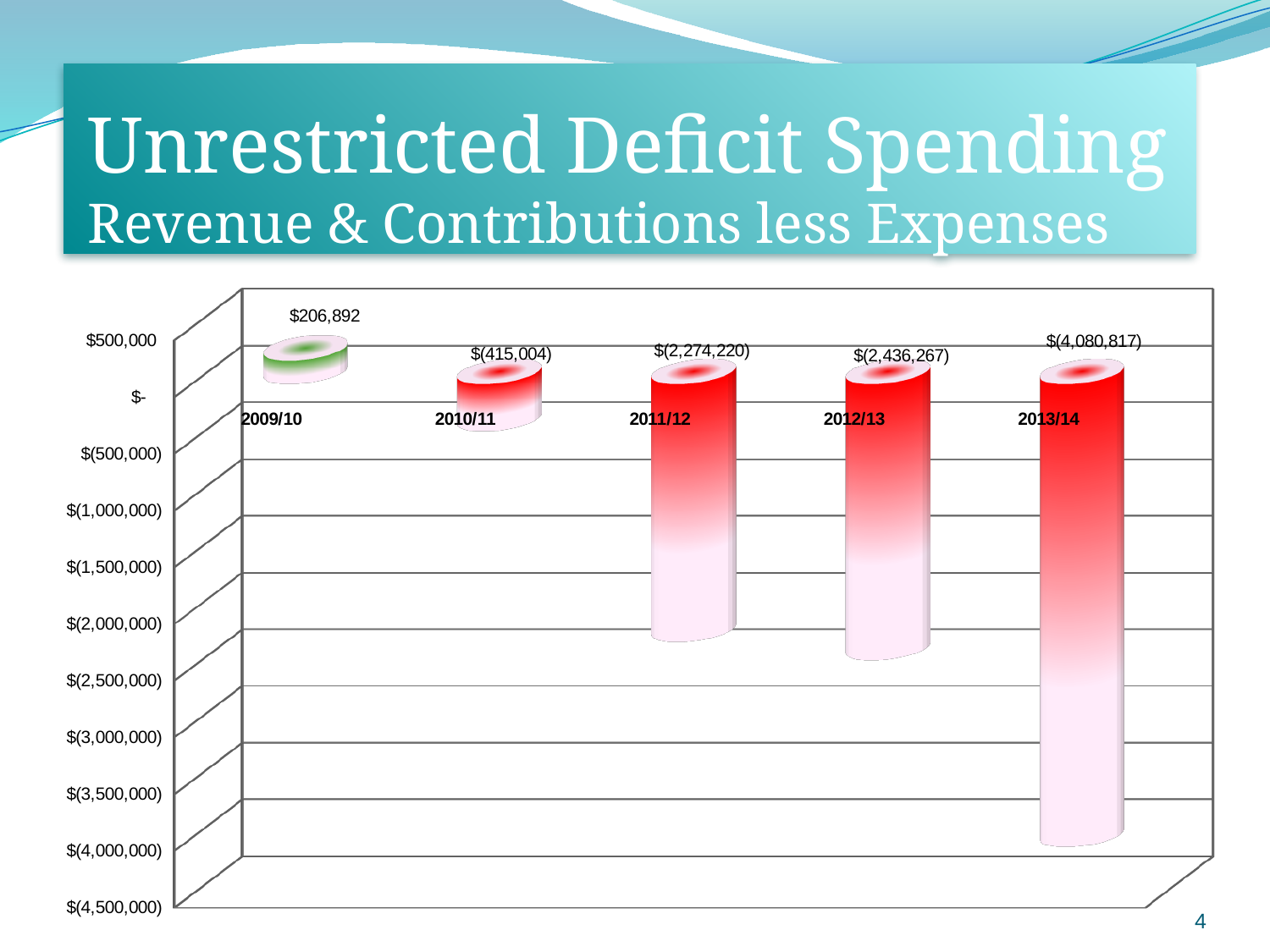
Is the value for 2011/12 greater or less than $(2,000,000)? less What is the value for 2011/12? $(2,274,220) What is the value for 2010/11? $(415,004) How many years are shown on the chart? 5 Which is larger, the value for 2010/11 or the value for 2012/13? 2010/11 What is the difference between the values for 2012/13 and 2011/12? $162,047 What is the value for 2009/10? $206,892 Do the values rise or fall from 2009/10 to 2013/14? fall Which year has the lowest value? 2013/14 What is the value for 2013/14? $(4,080,817) Which year has the highest value? 2009/10 What kind of chart is shown on the slide? bar chart